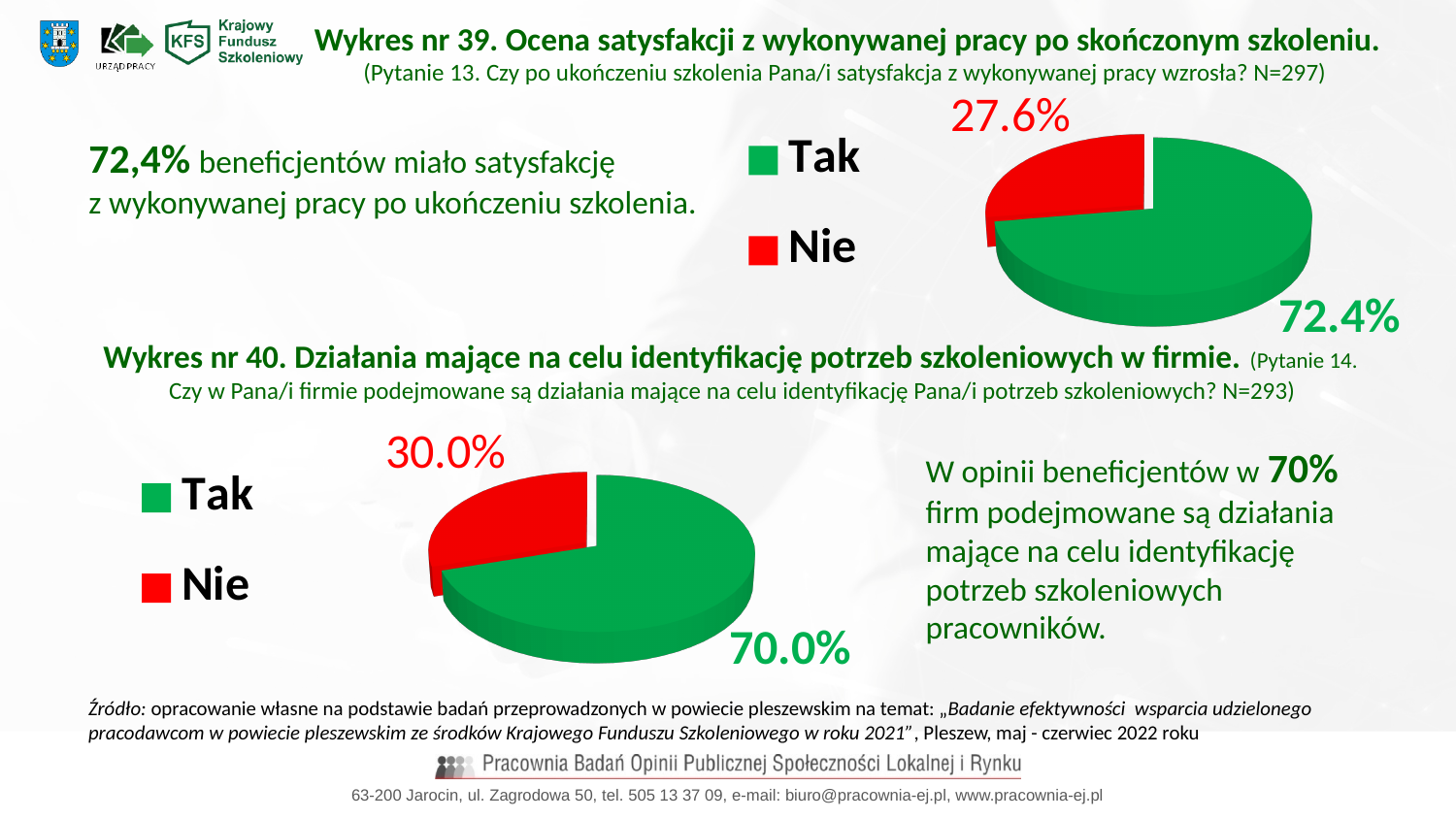
Is the 'Tak' share in the top chart (Wykres nr 39) larger or smaller than the 'Tak' share in the bottom chart (Wykres nr 40)? larger In the bottom chart (Wykres nr 40), what share of the pie is labelled 'Nie'? 30.0% How many categories does the legend of the top chart (Wykres nr 39) list? 2 In the top chart (Wykres nr 39), what share of the pie is labelled 'Tak'? 72.4% In the bottom chart (Wykres nr 40), what colour is the 'Nie' slice? red In the top chart (Wykres nr 39), what is the difference in percentage points between 'Tak' and 'Nie'? 44.8 In the bottom chart (Wykres nr 40), what share of the pie is labelled 'Tak'? 70.0% In the bottom chart (Wykres nr 40), what is the difference in percentage points between 'Tak' and 'Nie'? 40.0 What type of chart is used for Wykres nr 40 at the bottom of the slide? pie chart In the bottom chart (Wykres nr 40), which category has the smallest slice? Nie In the top chart (Wykres nr 39), which category has the largest slice? Tak In the top chart (Wykres nr 39), what share of the pie is labelled 'Nie'? 27.6%